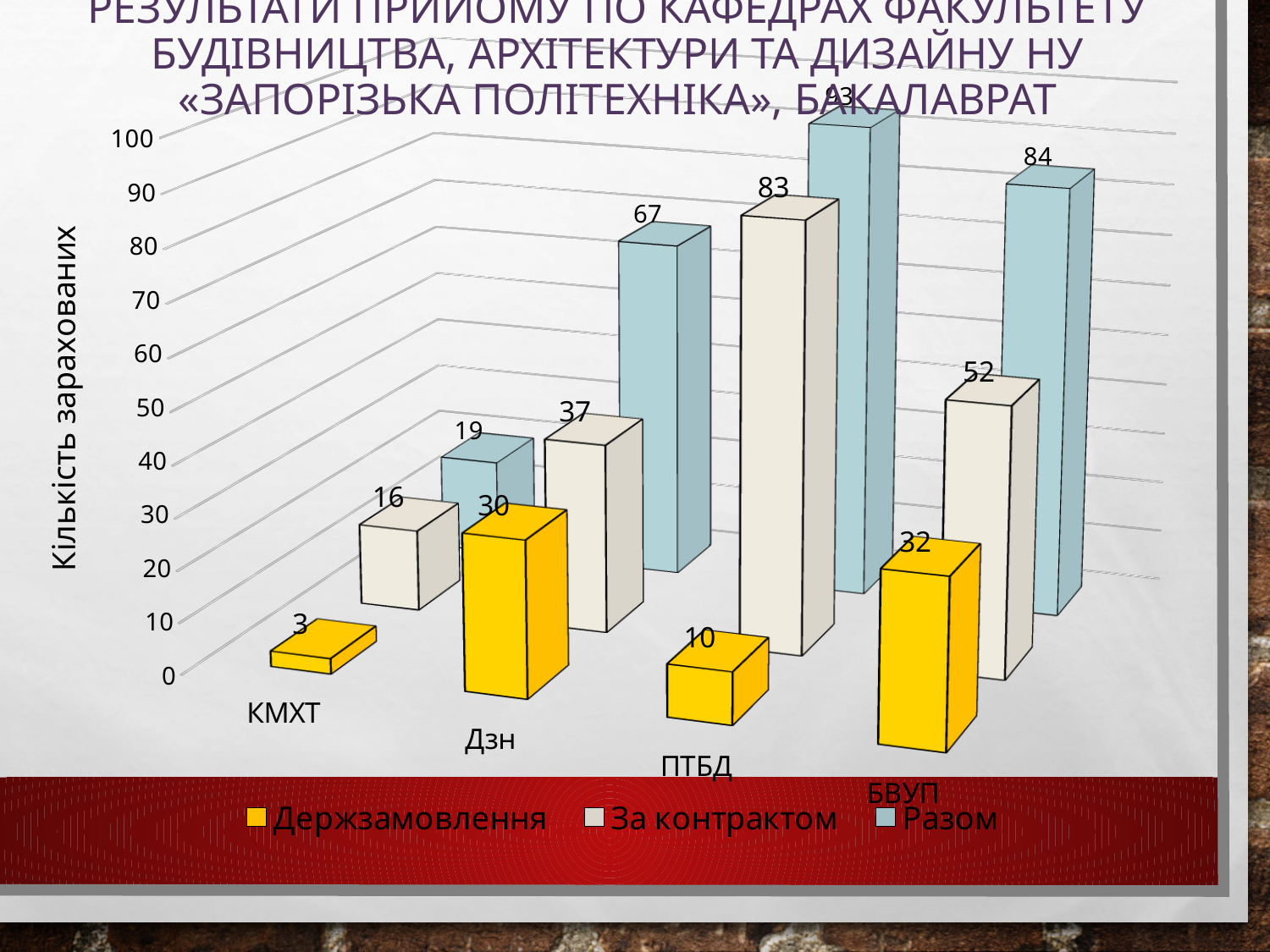
What kind of chart is shown on the slide? Bar chart What is the value of Держзамовлення for КМХТ? 3 How many series does the legend list? 3 What is the label of the vertical axis? Кількість зарахованих What is the value of За контрактом for ПТБД? 83 Which category has the lowest value for Разом? КМХТ What is the difference between За контрактом and Держзамовлення for БВУП? 20 Which is larger: Держзамовлення for Дзн or Держзамовлення for ПТБД? Держзамовлення for Дзн Which category has the highest value for За контрактом? ПТБД How many categories are shown on the x axis? 4 What is the value of Разом for БВУП? 84 What is the value of Держзамовлення for Дзн? 30